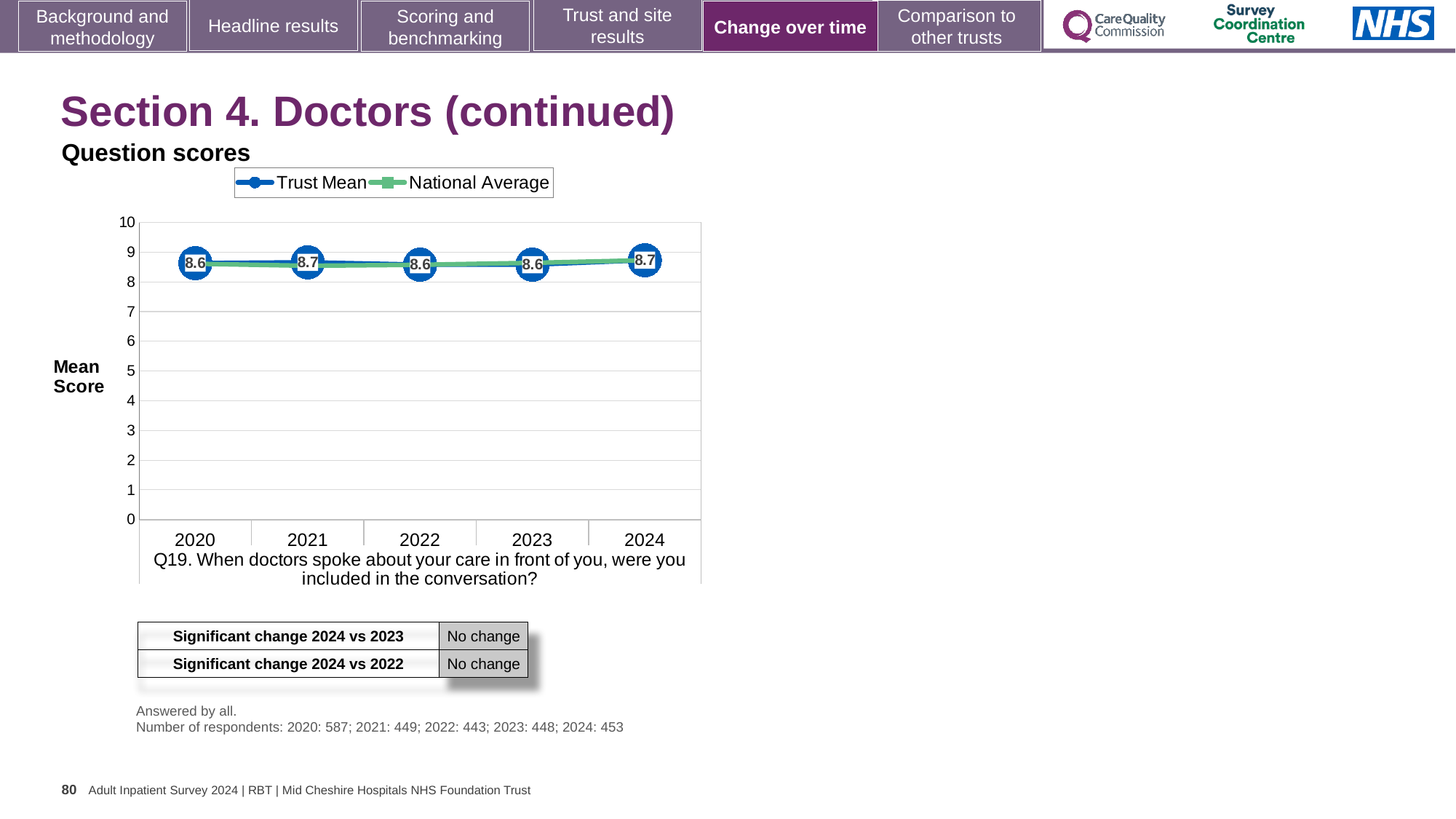
Is the Trust Mean score in 2024 higher or lower than in 2020? higher What is the Trust Mean score for 2021? 8.7 What is the difference between the Trust Mean score in 2024 and in 2023? 0.1 What is the Trust Mean score for 2024? 8.7 Is the National Average value for 2024 greater or less than 8? greater Is the National Average value for 2020 greater or less than 9? less How many series does the chart legend list? 2 How many years are plotted on the x axis of the chart? 5 What is the Trust Mean score for 2020? 8.6 What kind of chart is shown on the slide? line chart What are the two series named in the chart legend? Trust Mean and National Average What is the Trust Mean score for 2023? 8.6